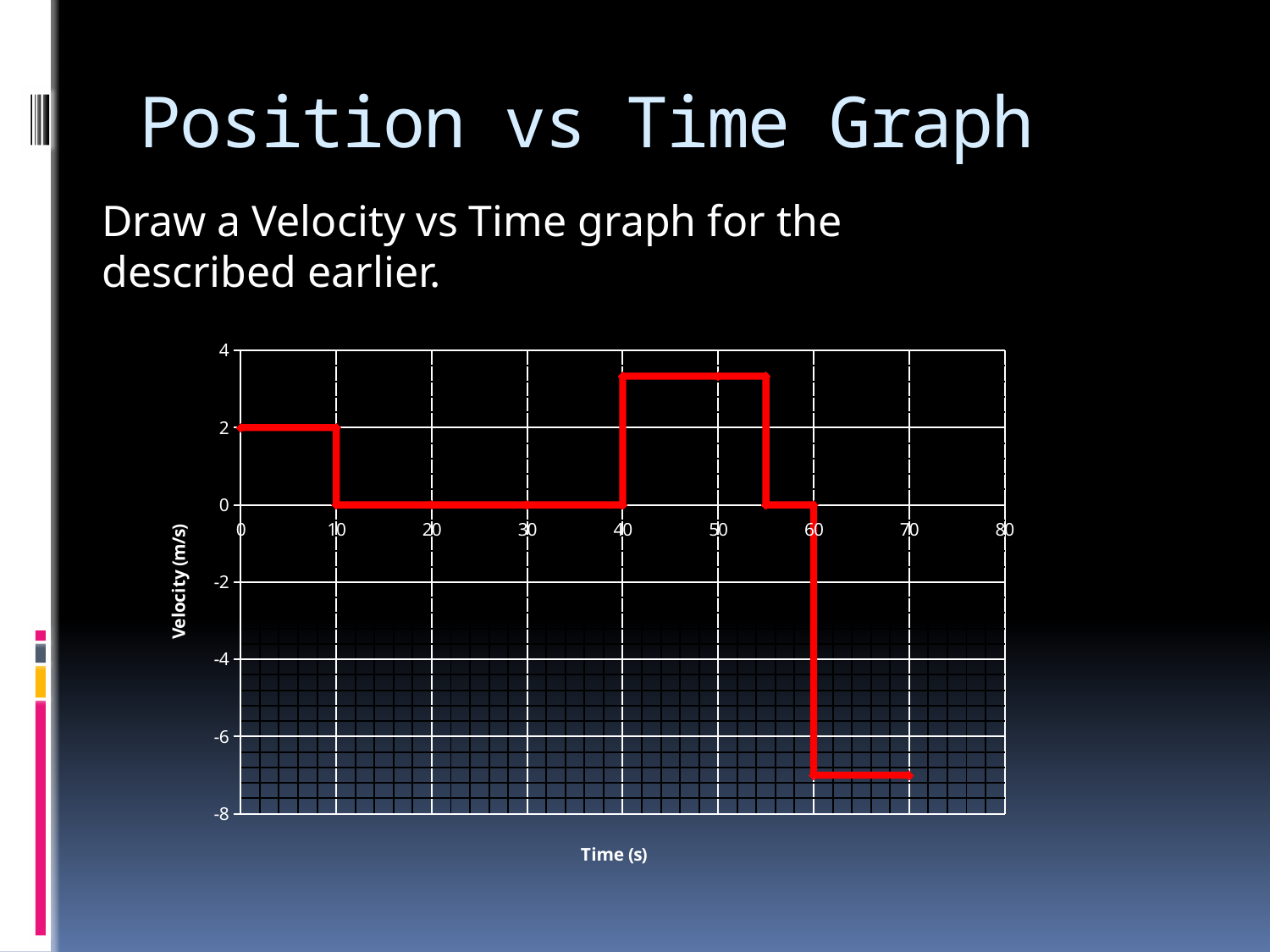
What is the label of the vertical axis? Velocity (m/s) Is the velocity between 40 and 55 seconds greater or less than 4? less Which is larger: the velocity between 0 and 10 seconds or the velocity between 40 and 55 seconds? 40 to 55 seconds Is the velocity between 40 and 55 seconds greater or less than 2? greater During which time interval is the velocity highest? 40 to 55 seconds Is the velocity between 60 and 70 seconds greater or less than -6? less What is the label of the horizontal axis? Time (s) What is the velocity shown between 10 and 40 seconds? 0 What kind of chart is shown on the slide? line chart Does the velocity rise or fall between 55 seconds and 70 seconds? fall What is the velocity shown between 0 and 10 seconds? 2 During which time interval is the velocity lowest? 60 to 70 seconds